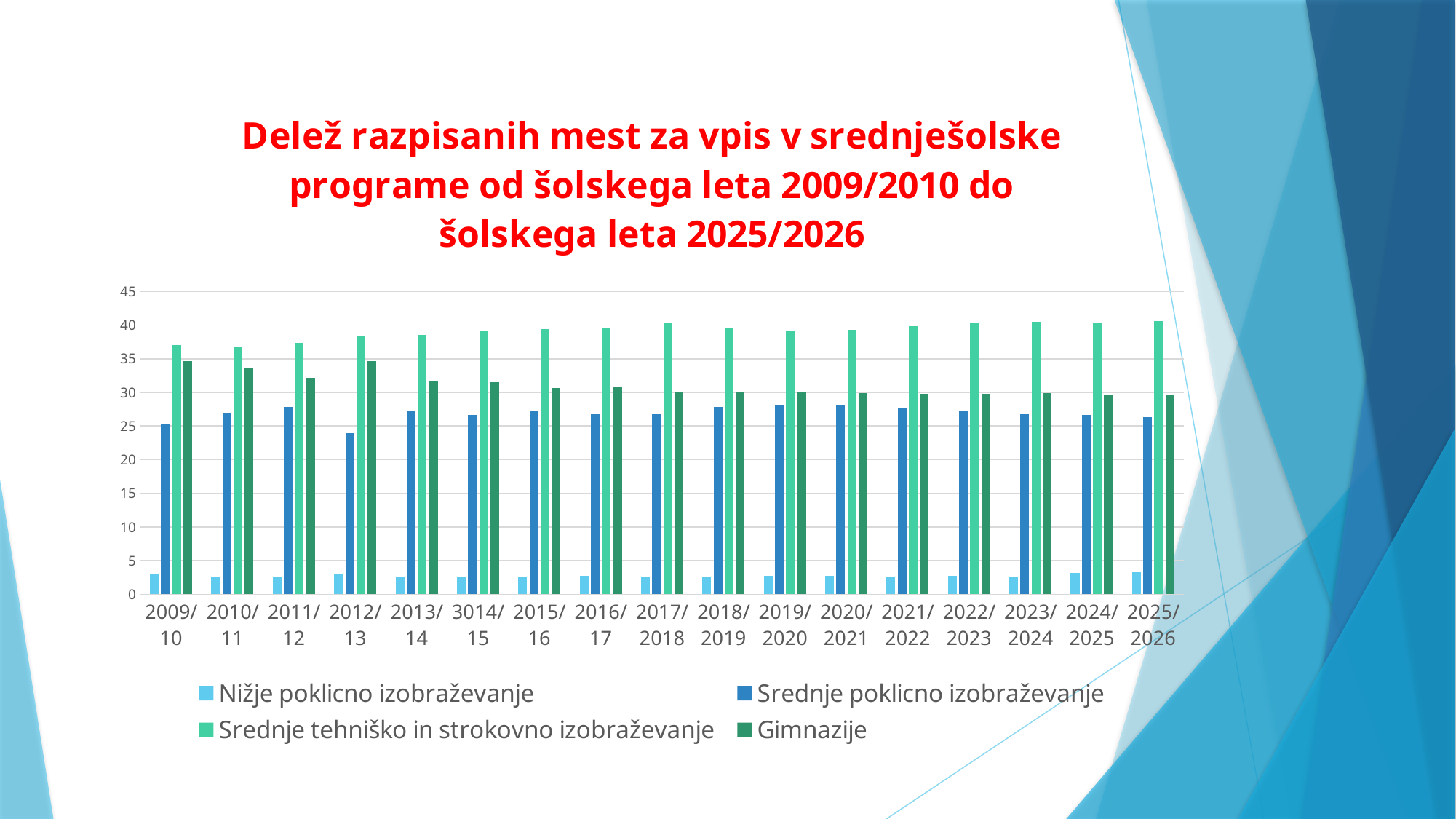
In which school year is the value for Srednje poklicno izobraževanje lowest? 2012/13 How many series does the legend list? 4 Which series has the lowest values across all school years? Nižje poklicno izobraževanje Is the value for Srednje poklicno izobraževanje in 2012/13 greater or less than 25? less Which series has the highest value in 2025/2026? Srednje tehniško in strokovno izobraževanje In 2012/13, which is larger: Srednje poklicno izobraževanje or Gimnazije? Gimnazije How many school years are shown on the x axis? 17 Do the values for Gimnazije generally rise or fall from 2009/10 to 2025/2026? fall Is the value for Srednje tehniško in strokovno izobraževanje in 2025/2026 greater or less than 40? greater What kind of chart is shown on the slide? bar chart Is the value for Gimnazije in 2011/12 greater or less than 30? greater